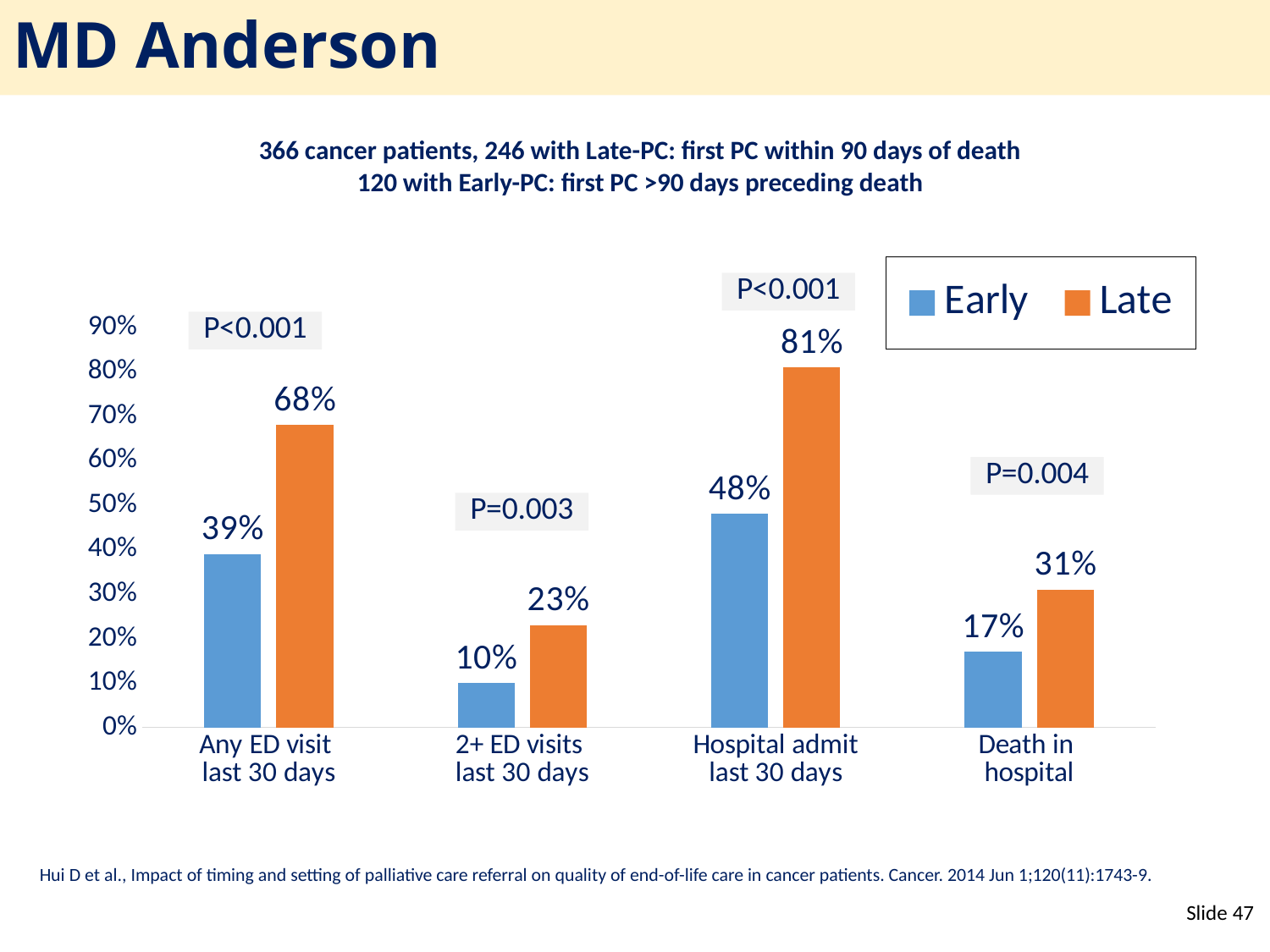
How many categories are shown on the x axis? 4 Which category has the highest Late value? Hospital admit last 30 days What is the difference between the Late and Early values for Any ED visit last 30 days? 29% What is the Late value for 2+ ED visits last 30 days? 23% What is the Late value for Any ED visit last 30 days? 68% Which category has the lowest Early value? 2+ ED visits last 30 days What is the Early value for Death in hospital? 17% What is the difference between the Late and Early values for Hospital admit last 30 days? 33% What is the Early value for Hospital admit last 30 days? 48% Which is larger for Death in hospital, the Early value or the Late value? Late How many series does the legend list? 2 What kind of chart is shown on the slide? Bar chart